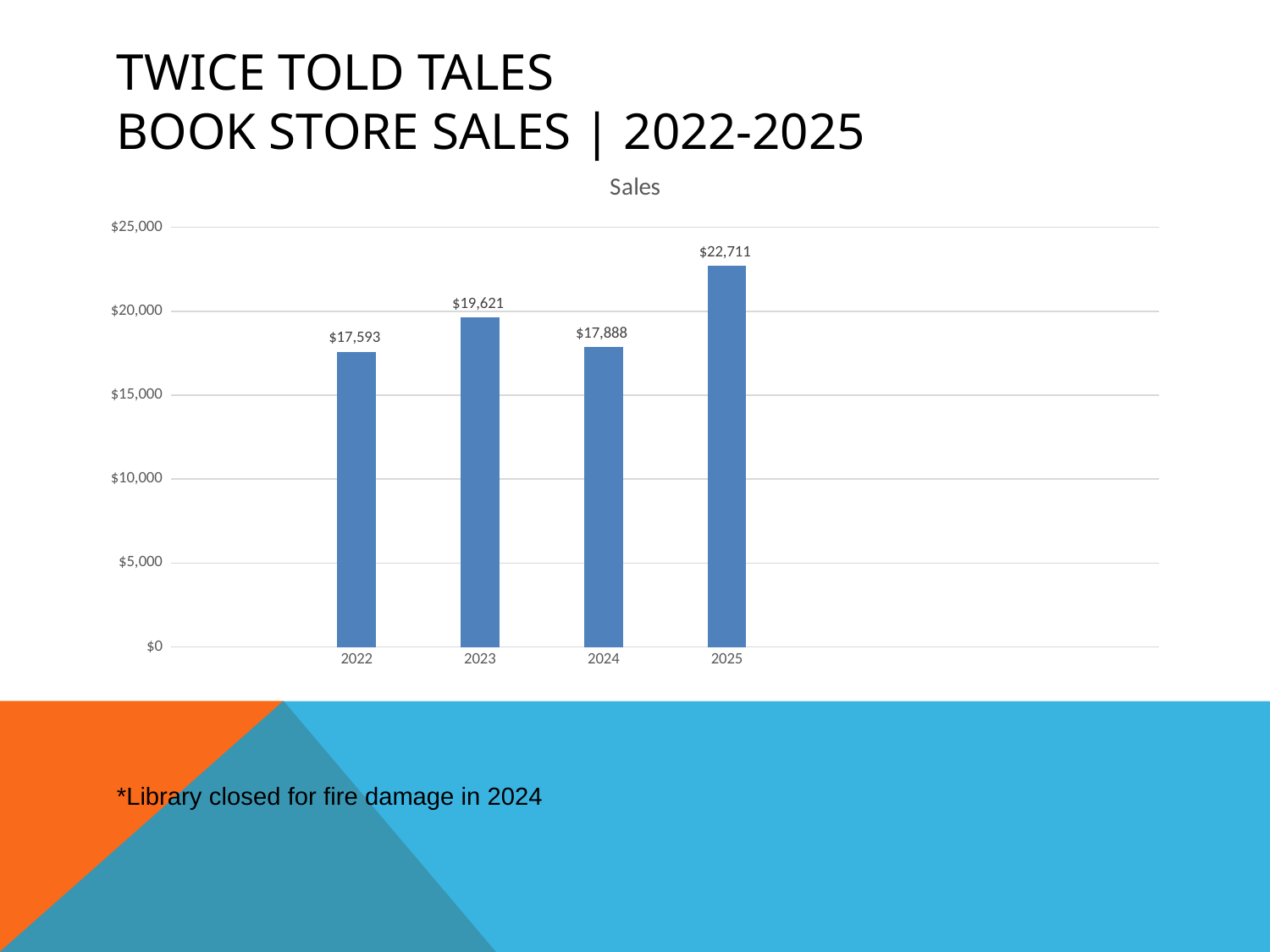
Which year has the highest sales? 2025 What is the sales value for 2025? $22,711 What is the sales value for 2024? $17,888 What kind of chart is shown on the slide? Bar chart Is the sales value for 2025 greater or less than $20,000? greater Which year has the lowest sales? 2022 What is the difference in sales between 2023 and 2022? $2,028 What is the sales value for 2022? $17,593 What is the title of the chart? Sales How many years are shown on the chart? 4 Which year had higher sales, 2023 or 2024? 2023 What is the difference in sales between 2025 and 2024? $4,823